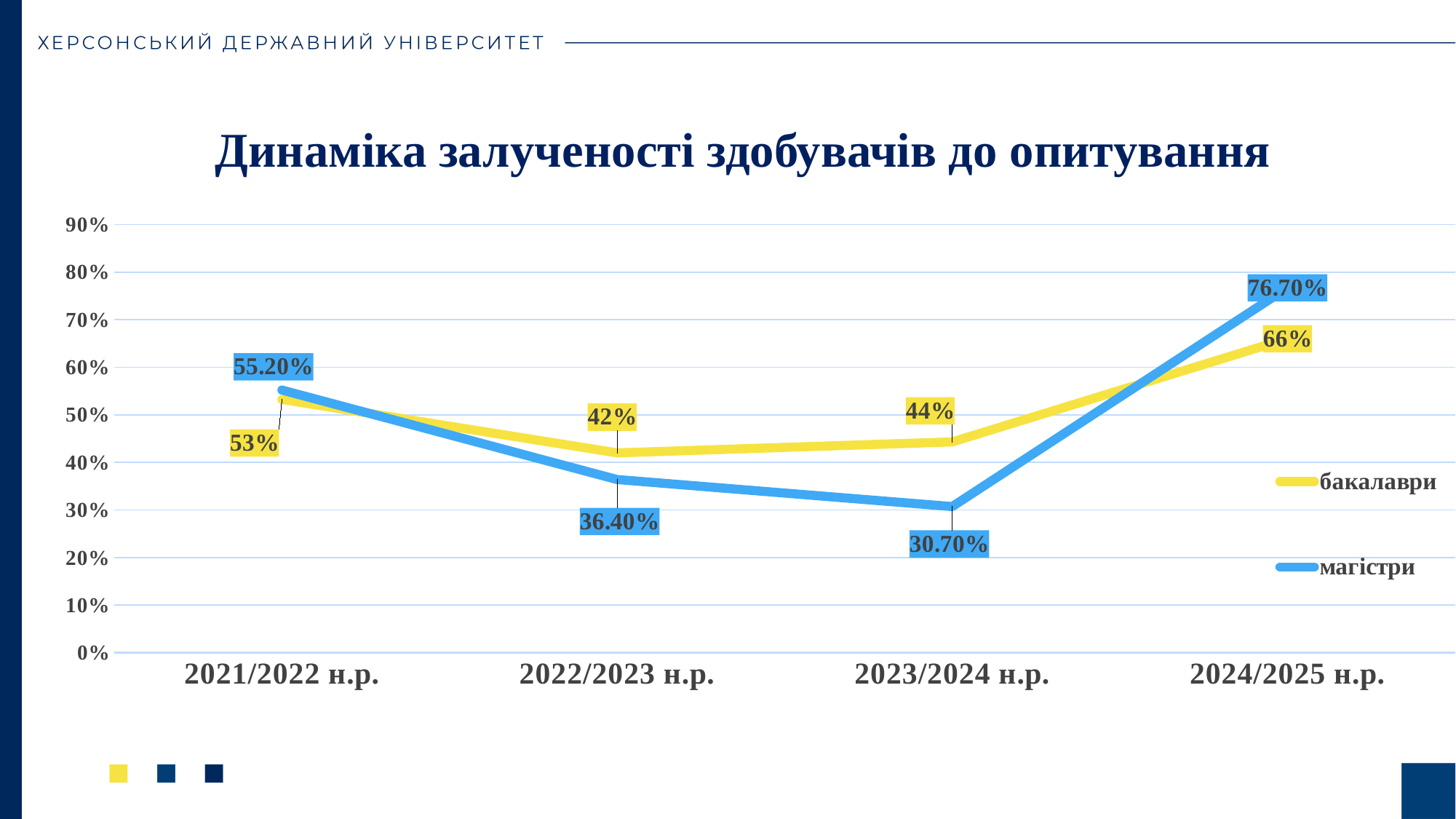
What is the difference between the магістри and бакалаври values in 2024/2025 н.р.? 10.70% Which series has the larger value in 2022/2023 н.р., бакалаври or магістри? бакалаври What kind of chart is shown on the slide? line chart In which academic year is the value for бакалаври highest? 2024/2025 н.р. What is the value for бакалаври in 2022/2023 н.р.? 42% In which academic year is the value for магістри lowest? 2023/2024 н.р. What is the value for магістри in 2024/2025 н.р.? 76.70% What is the value for магістри in 2023/2024 н.р.? 30.70% What is the value for бакалаври in 2021/2022 н.р.? 53% How many series does the legend list? 2 What is the title of the chart? Динаміка залученості здобувачів до опитування How many academic years are shown on the x axis? 4